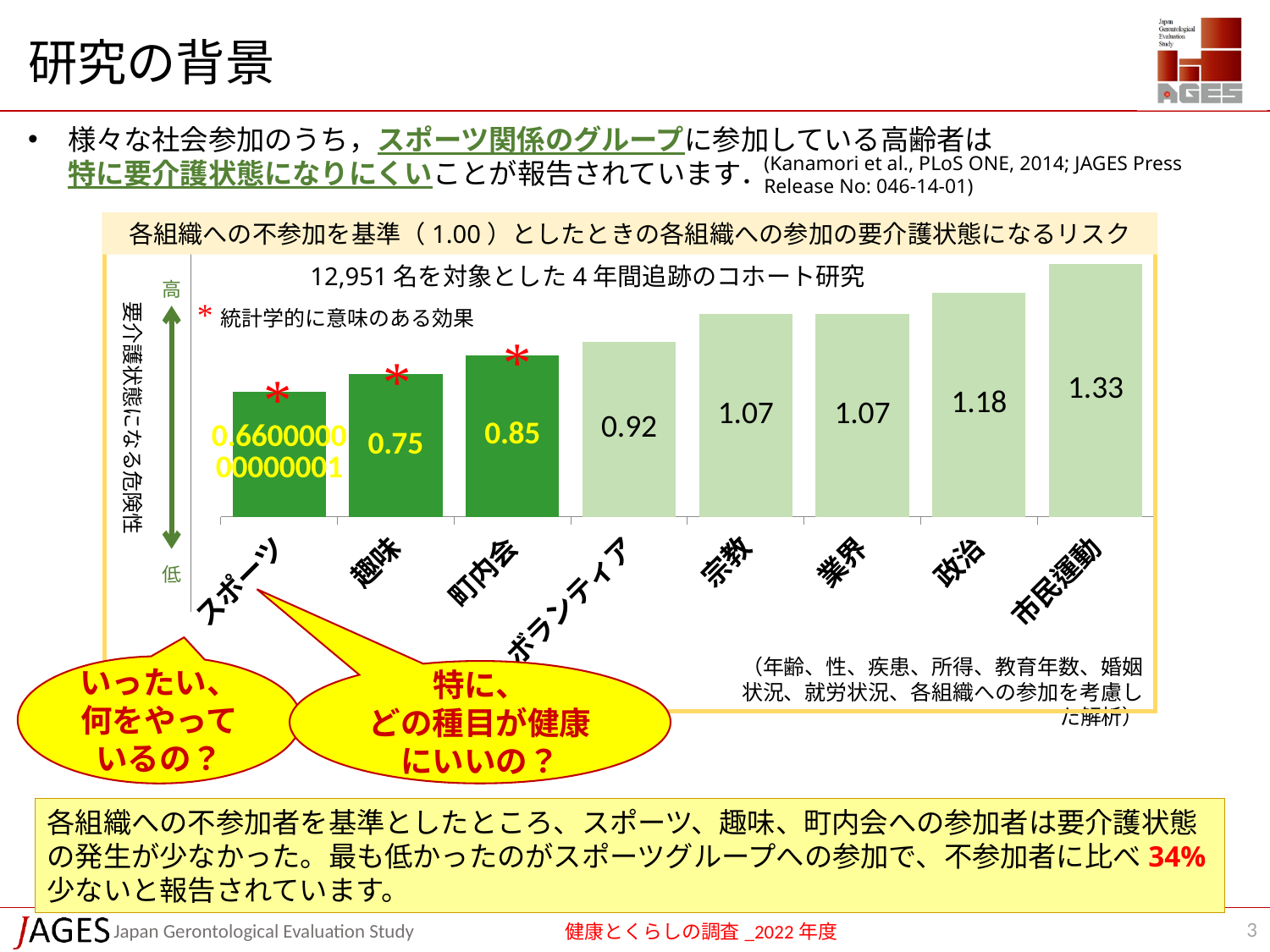
How many organization categories are plotted in the chart? 8 Do the values rise or fall moving from left to right along the x axis? Rise How many bars are marked with a red asterisk indicating a statistically significant effect? 3 Which category has the lowest risk value in the chart? スポーツ What type of chart is shown on the slide? Bar chart What is the difference between the values for 市民運動 and 政治? 0.15 What is the risk value for 趣味? 0.75 What is the risk value for 政治? 1.18 What is the risk value for 町内会? 0.85 What is the risk value for ボランティア? 0.92 Which has a larger value, 趣味 or ボランティア? ボランティア Which category has the highest risk value in the chart? 市民運動